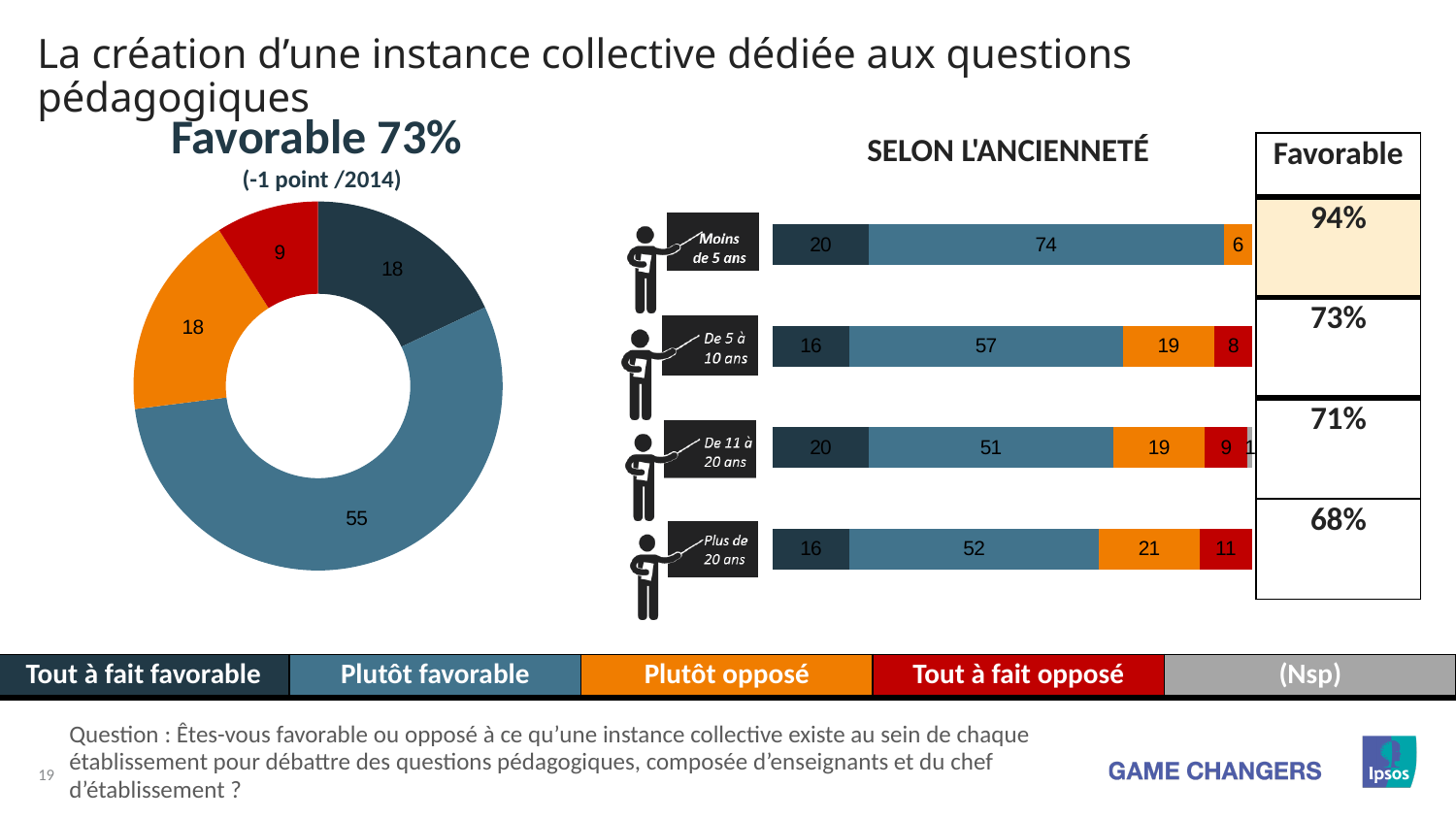
In the 'SELON L'ANCIENNETÉ' bar chart, is the Tout à fait opposé value larger for 'De 5 à 10 ans' or for 'Plus de 20 ans'? Plus de 20 ans How many series does the legend at the bottom of the slide list? 5 In the donut chart on the left, which category has the smallest slice? Tout à fait opposé In the 'SELON L'ANCIENNETÉ' bar chart, how many seniority groups are shown? 4 In the donut chart on the left, what is the difference between the Plutôt favorable value and the Tout à fait favorable value? 37 In the 'SELON L'ANCIENNETÉ' bar chart, which seniority group has the highest Plutôt favorable value? Moins de 5 ans What type of chart is the 'SELON L'ANCIENNETÉ' chart? Stacked bar chart In the donut chart on the left, what is the value of the largest slice (Plutôt favorable)? 55 In the donut chart on the left, what is the value of the Tout à fait opposé slice? 9 According to the 'Favorable' column next to the bar chart, what is the Favorable percentage for 'De 11 à 20 ans'? 71% In the 'SELON L'ANCIENNETÉ' bar chart, what is the Plutôt opposé value for 'Plus de 20 ans'? 21 In the 'SELON L'ANCIENNETÉ' bar chart, what is the Plutôt favorable value for 'Moins de 5 ans'? 74